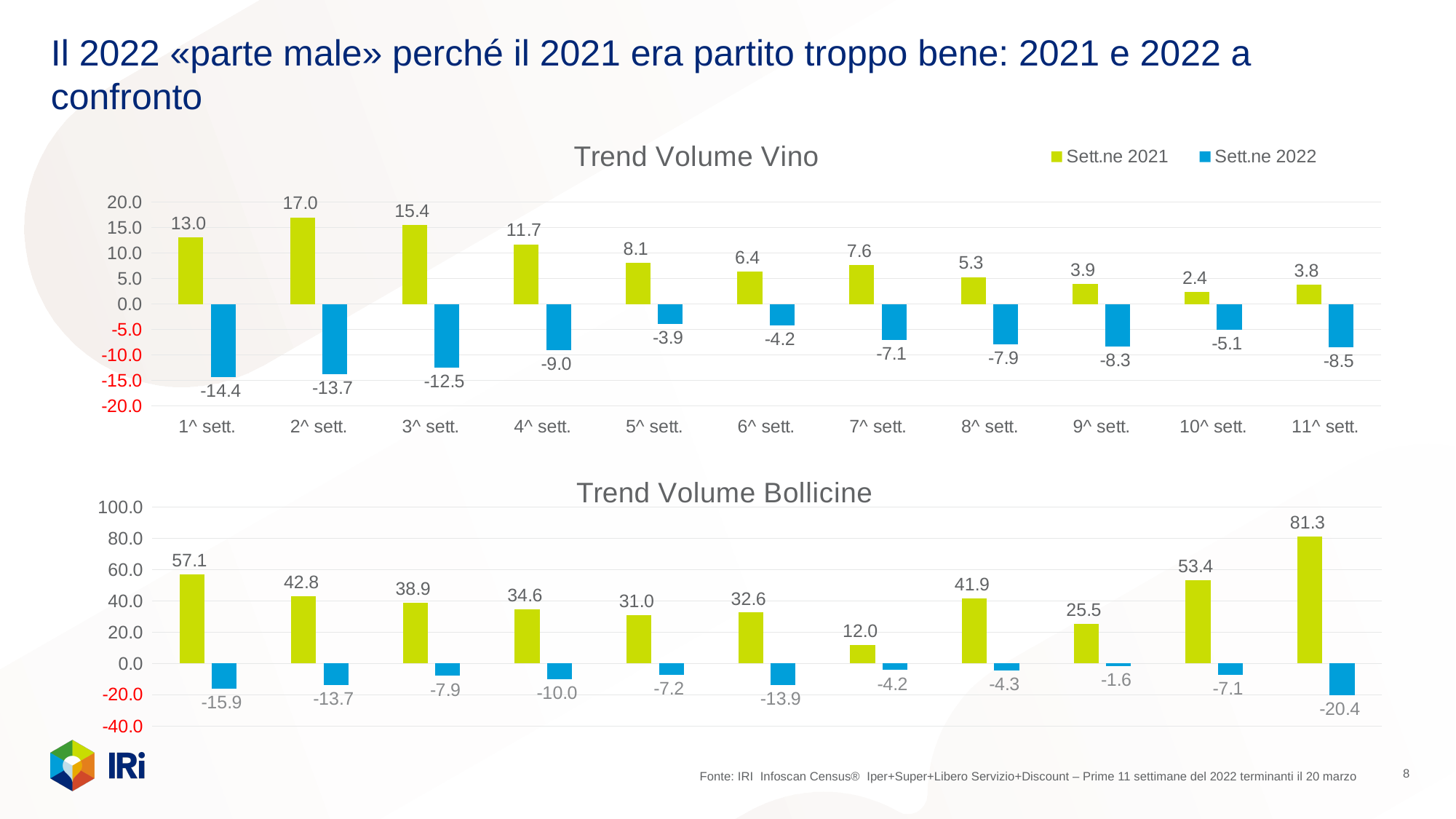
In the 'Trend Volume Vino' chart, which week has the highest Sett.ne 2021 value? 2^ sett. In the 'Trend Volume Bollicine' chart, what is the value for Sett.ne 2022 in 9^ sett.? -1.6 How many weeks are shown on the x axis of the 'Trend Volume Vino' chart? 11 In the 'Trend Volume Bollicine' chart, which week has the lowest Sett.ne 2022 value? 11^ sett. In the 'Trend Volume Bollicine' chart, what is the value for Sett.ne 2021 in 11^ sett.? 81.3 How many series does the legend list for the charts on this slide? 2 In the 'Trend Volume Vino' chart, what is the difference between the Sett.ne 2021 value and the Sett.ne 2022 value in 4^ sett.? 20.7 In the 'Trend Volume Bollicine' chart, which is larger: the Sett.ne 2021 value in 1^ sett. or in 10^ sett.? 1^ sett. In the 'Trend Volume Bollicine' chart, which week has the lowest Sett.ne 2021 value? 7^ sett. In the 'Trend Volume Vino' chart, what is the value for Sett.ne 2021 in 2^ sett.? 17.0 In the 'Trend Volume Vino' chart, which week has the lowest Sett.ne 2021 value? 10^ sett. In the 'Trend Volume Vino' chart, what is the value for Sett.ne 2022 in 1^ sett.? -14.4